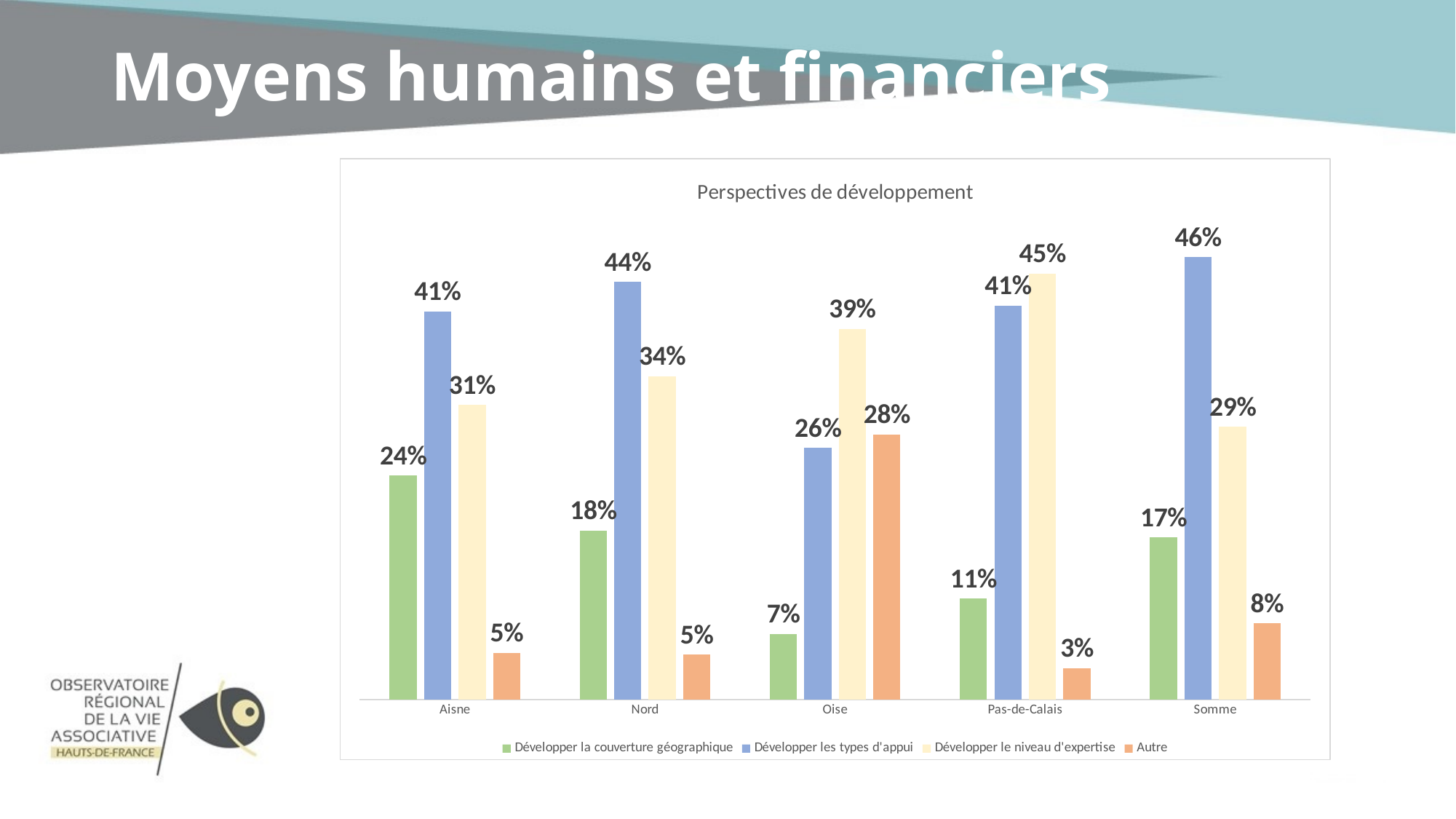
What is the difference between 'Développer le niveau d'expertise' and 'Développer la couverture géographique' in Pas-de-Calais? 34% What is the value for 'Développer la couverture géographique' in Oise? 7% What kind of chart is shown? Bar chart Which department has the highest value for 'Développer les types d'appui'? Somme In Oise, which is larger: 'Développer les types d'appui' or 'Développer le niveau d'expertise'? Développer le niveau d'expertise How many departments are shown on the x axis? 5 How many series does the legend list? 4 What is the value for 'Autre' in Pas-de-Calais? 3% What is the value for 'Développer les types d'appui' in Somme? 46% What is the title of the chart? Perspectives de développement What is the value for 'Développer le niveau d'expertise' in Nord? 34% Which department has the lowest value for 'Développer la couverture géographique'? Oise